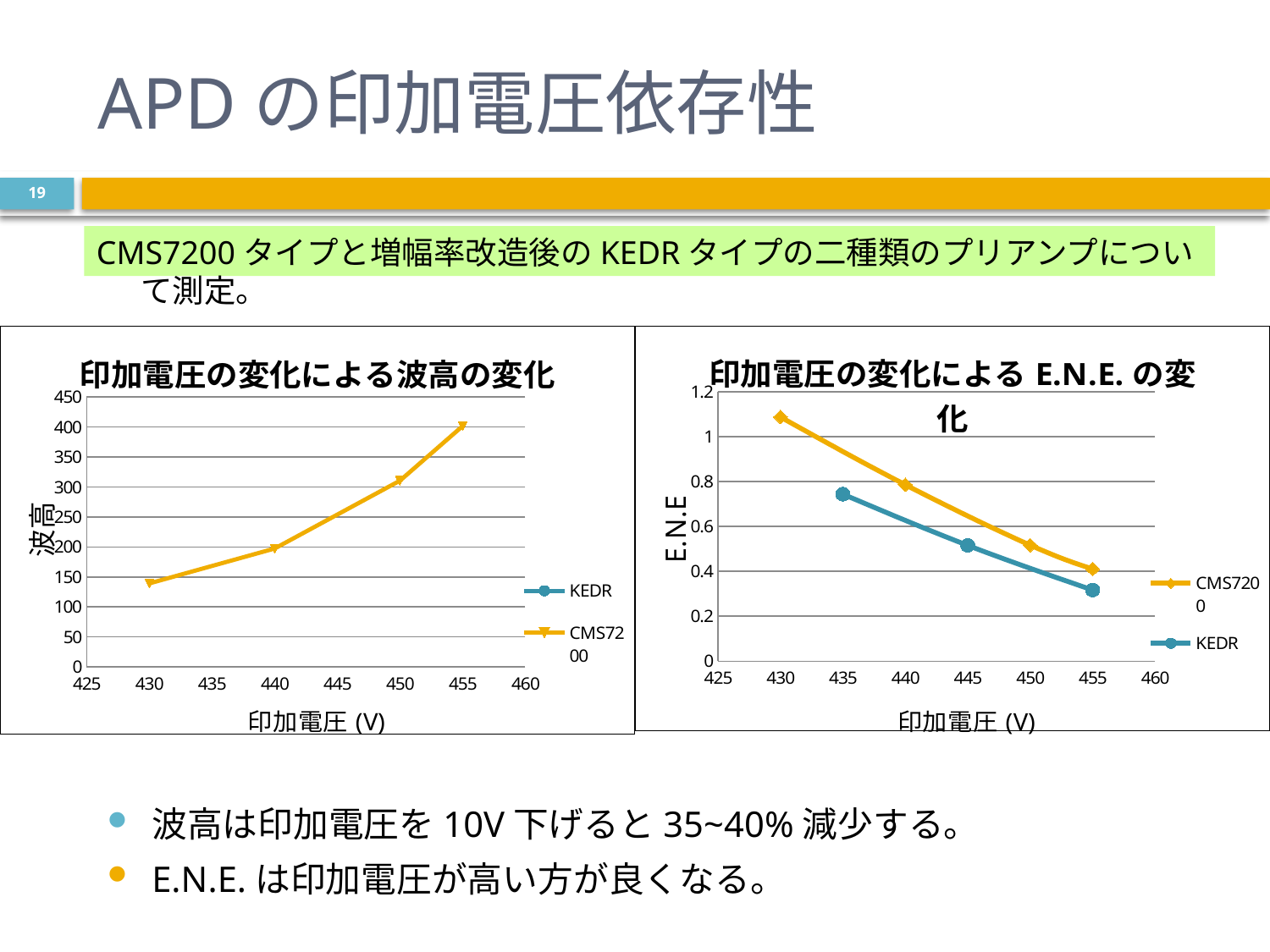
In the right chart titled 印加電圧の変化による E.N.E. の変化, is the KEDR value at 455 V greater or less than 0.4? less In the right chart titled 印加電圧の変化による E.N.E. の変化, how many data points are plotted for the KEDR series? 3 In the left chart titled 印加電圧の変化による波高の変化, how many series does the legend list? 2 In the right chart titled 印加電圧の変化による E.N.E. の変化, is the CMS7200 value at 430 V greater or less than 1? greater In the left chart titled 印加電圧の変化による波高の変化, does the CMS7200 line rise or fall as 印加電圧 increases? rise In the right chart titled 印加電圧の変化による E.N.E. の変化, what is the x-axis title? 印加電圧 (V) In the right chart titled 印加電圧の変化による E.N.E. の変化, does the CMS7200 line rise or fall as 印加電圧 increases? fall In the left chart titled 印加電圧の変化による波高の変化, is the CMS7200 value at 455 V greater or less than 350? greater In the right chart titled 印加電圧の変化による E.N.E. の変化, at 455 V which series has the larger value, CMS7200 or KEDR? CMS7200 In the left chart titled 印加電圧の変化による波高の変化, what kind of chart is it? line chart In the right chart titled 印加電圧の変化による E.N.E. の変化, how many series does the legend list? 2